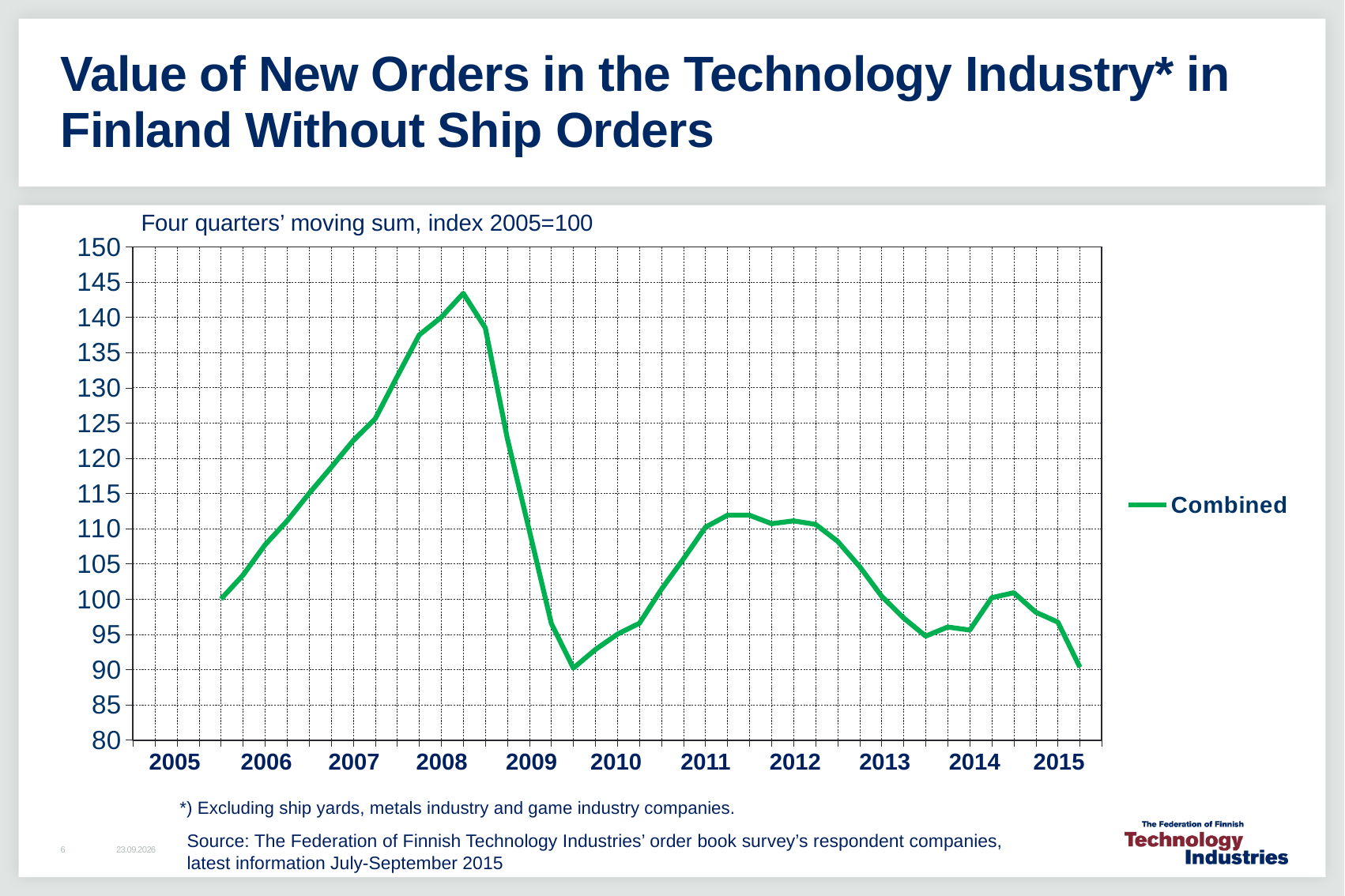
Does the Combined line rise or fall between 2008 and 2009? fall Is the value of the Combined line in mid-2011 greater or less than 105? greater What subtitle describes the index used in the chart? Four quarters' moving sum, index 2005=100 Does the Combined line rise or fall between 2005 and 2008? rise What kind of chart is shown on the slide? line chart In which year does the Combined line reach its highest value? 2008 How many series does the legend list? 1 Is the peak value of the Combined line in 2008 greater or less than 140? greater Is the lowest value of the Combined line in 2009 greater or less than 95? less What is the name of the series shown in the legend? Combined How many years are labelled on the x axis? 11